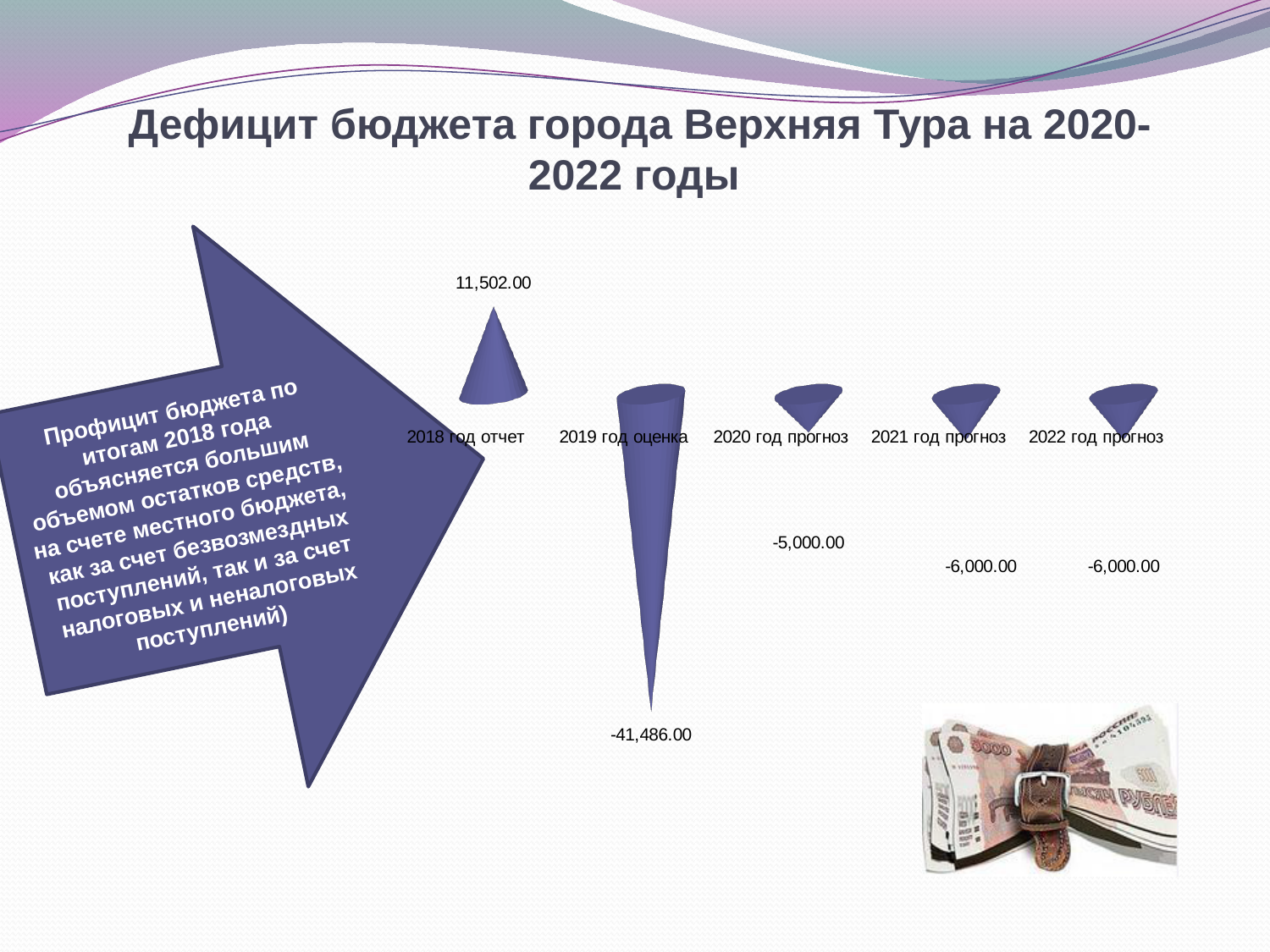
What is the title of the slide containing the chart? Дефицит бюджета города Верхняя Тура на 2020-2022 годы What is the value for 2022 год прогноз? -6,000.00 What is the difference between the values for 2020 год прогноз and 2021 год прогноз? 1,000.00 What is the value for 2019 год оценка? -41,486.00 What is the value for 2018 год отчет? 11,502.00 Which is larger, the value for 2020 год прогноз or the value for 2021 год прогноз? 2020 год прогноз How many categories are shown in the chart? 5 Which category has the highest value? 2018 год отчет What is the value for 2021 год прогноз? -6,000.00 Which category has the lowest value? 2019 год оценка What is the difference between the values for 2018 год отчет and 2019 год оценка? 52,988.00 What is the value for 2020 год прогноз? -5,000.00